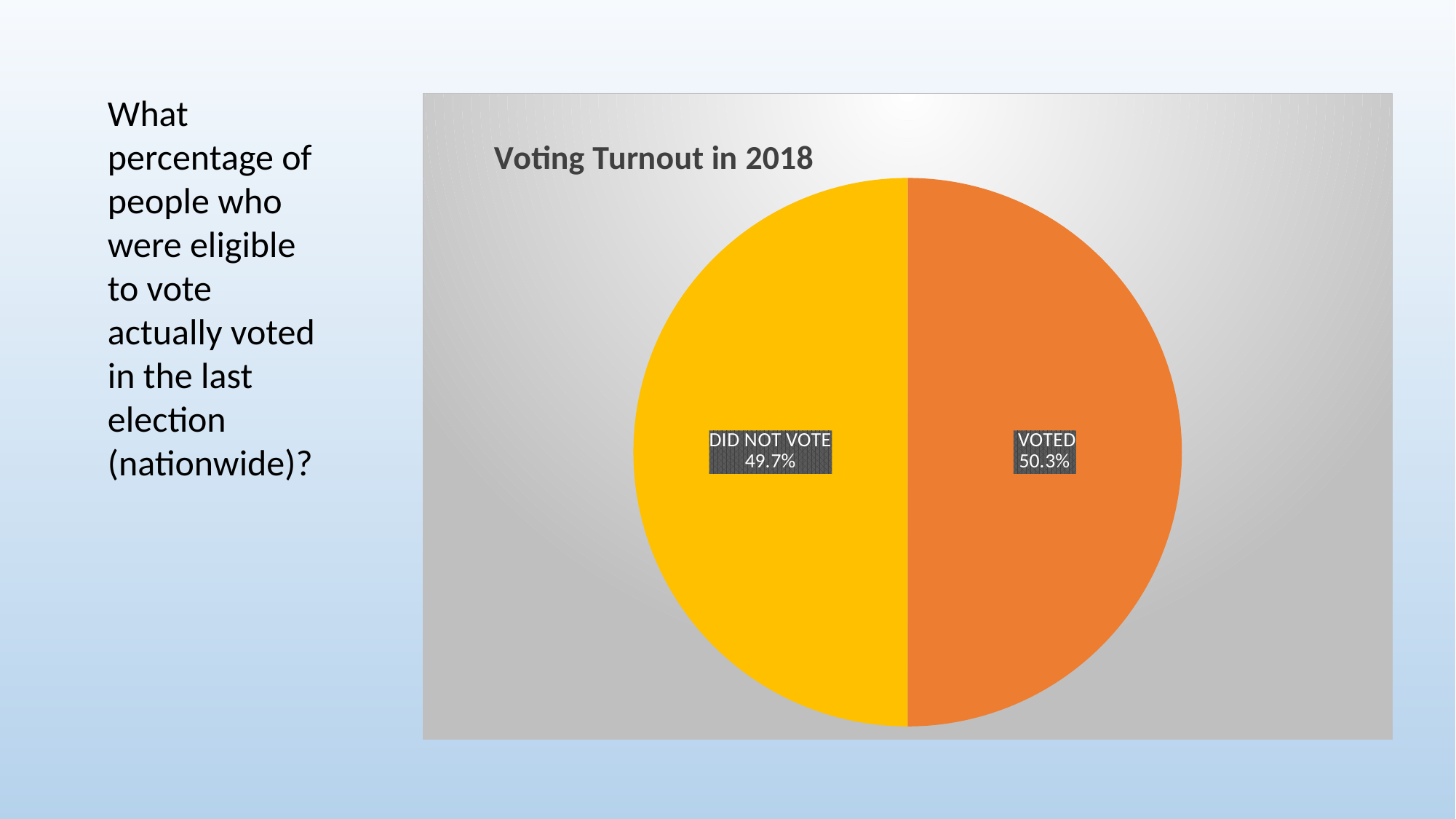
Which category has the largest share of the pie? VOTED Which category has the smallest share of the pie? DID NOT VOTE What percentage is shown for the VOTED slice? 50.3% What colour is the VOTED slice? orange What is the difference between the VOTED and DID NOT VOTE percentages? 0.6% Is the value for VOTED greater or less than 50%? greater What is the title of the chart? Voting Turnout in 2018 Which slice is larger, VOTED or DID NOT VOTE? VOTED What type of chart is shown on the slide? pie chart What share of the pie does the DID NOT VOTE slice represent? 49.7% What percentage is shown for the DID NOT VOTE slice? 49.7% How many slices does the pie chart have? 2